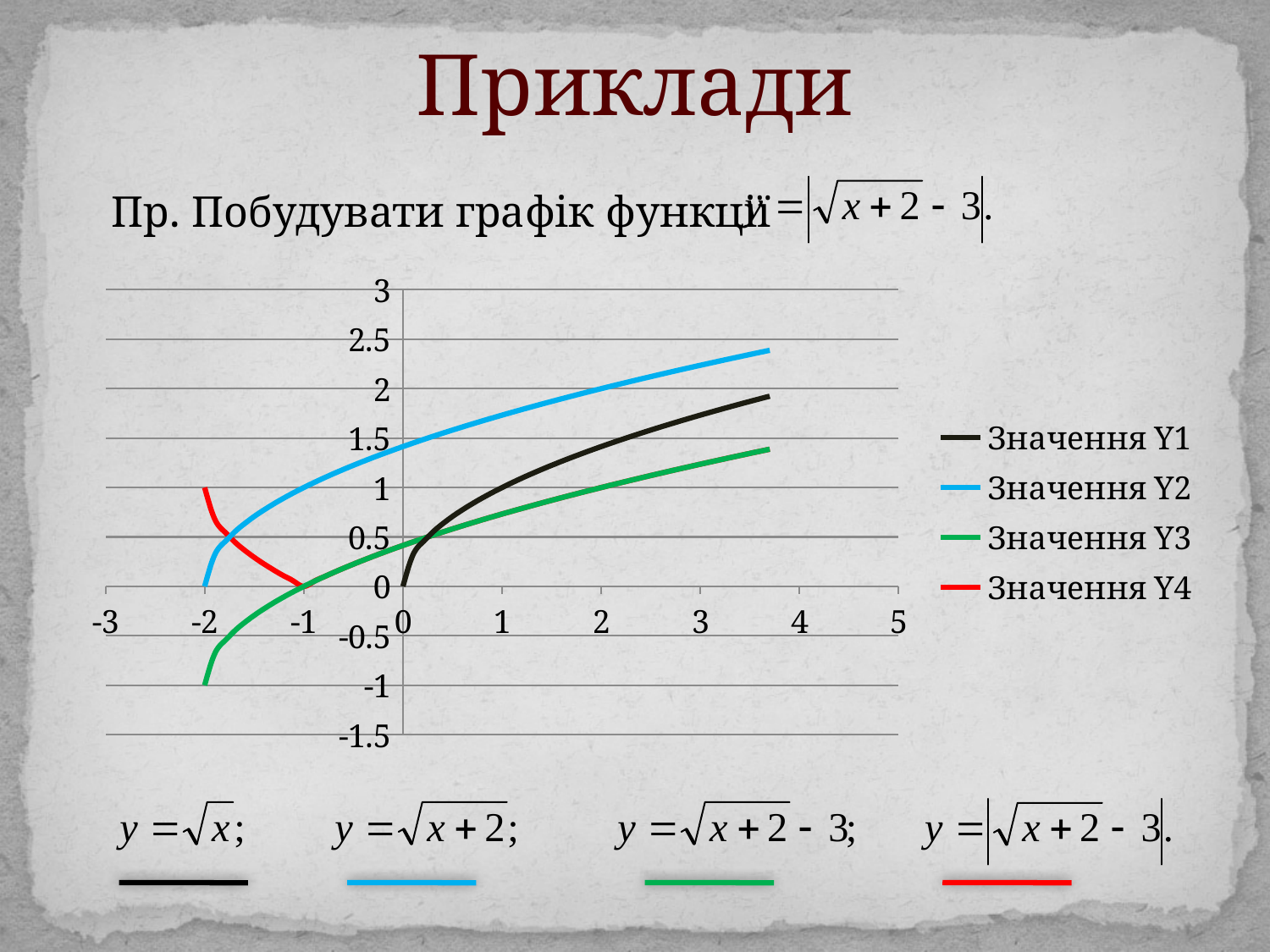
At x = 0, is the value of Значення Y3 greater or less than 0.5? less At x = 3, is the value of Значення Y2 greater or less than 2? greater At x = 3, which is larger: Значення Y2 or Значення Y3? Значення Y2 Which series reaches the highest value on the chart? Значення Y2 At x = 1, which is larger: Значення Y1 or Значення Y3? Значення Y1 Which series is drawn in red? Значення Y4 How many series does the legend list? 4 What kind of chart is shown on the slide? line chart At x = 3, is the value of Значення Y1 greater or less than 1.5? greater At which x value does Значення Y3 cross the x axis (y = 0)? -1 Which series is drawn in green? Значення Y3 Does Значення Y1 rise or fall as x increases? rises